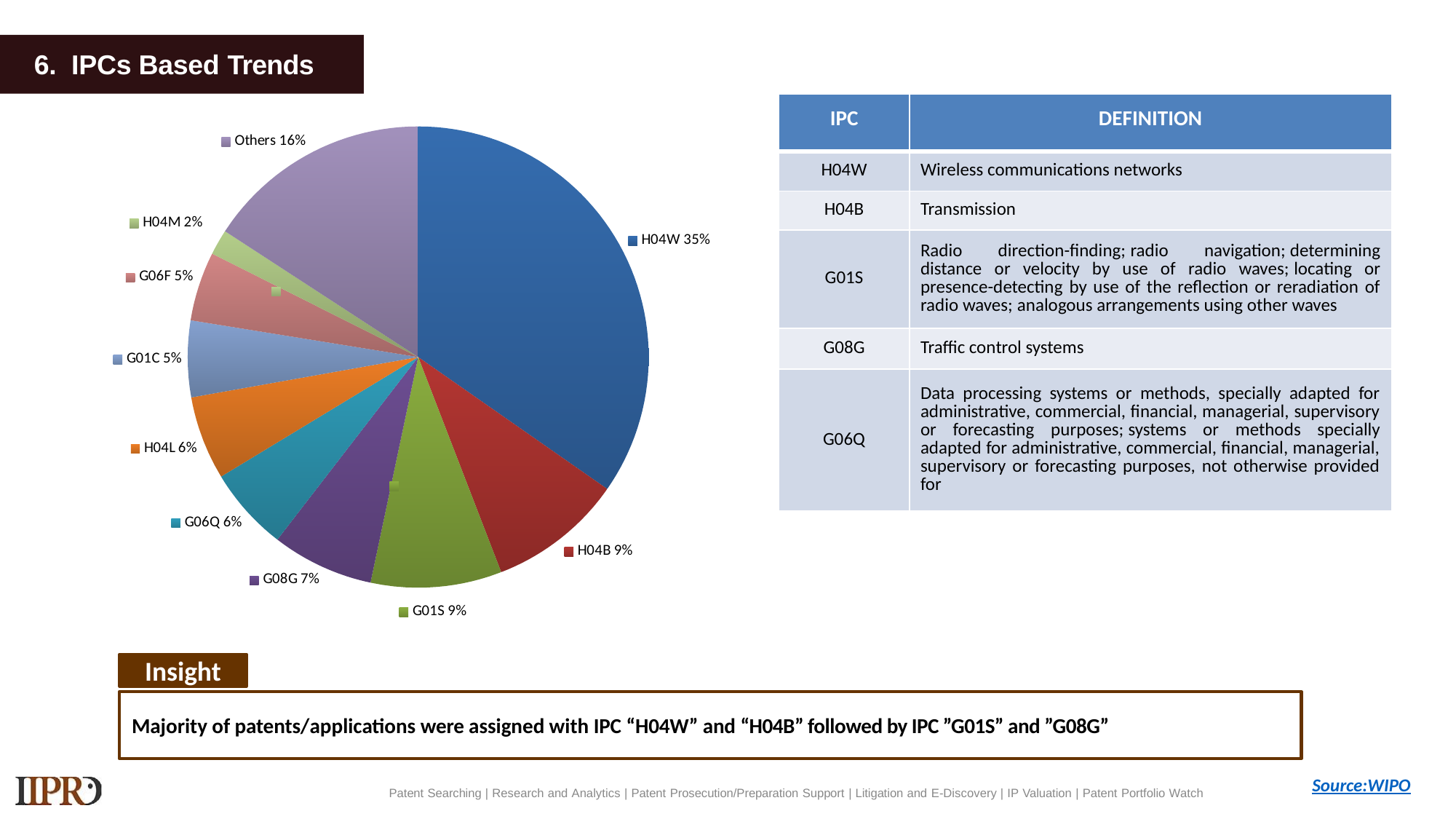
What kind of chart is shown on the slide? pie chart Which has a larger share, G06Q or G01C? G06Q What is the title of the slide containing the pie chart? 6. IPCs Based Trends What percentage is shown for G08G? 7% Which IPC slice has the largest share of the pie? H04W What percentage is shown for the Others slice? 16% How many slices does the pie chart have? 10 What is the difference in percentage points between H04W and H04B? 26 What share of the pie does H04W hold? 35% What is the combined share of H04B and G01S? 18% Which IPC slice has the smallest share of the pie? H04M What percentage is shown for G06F? 5%